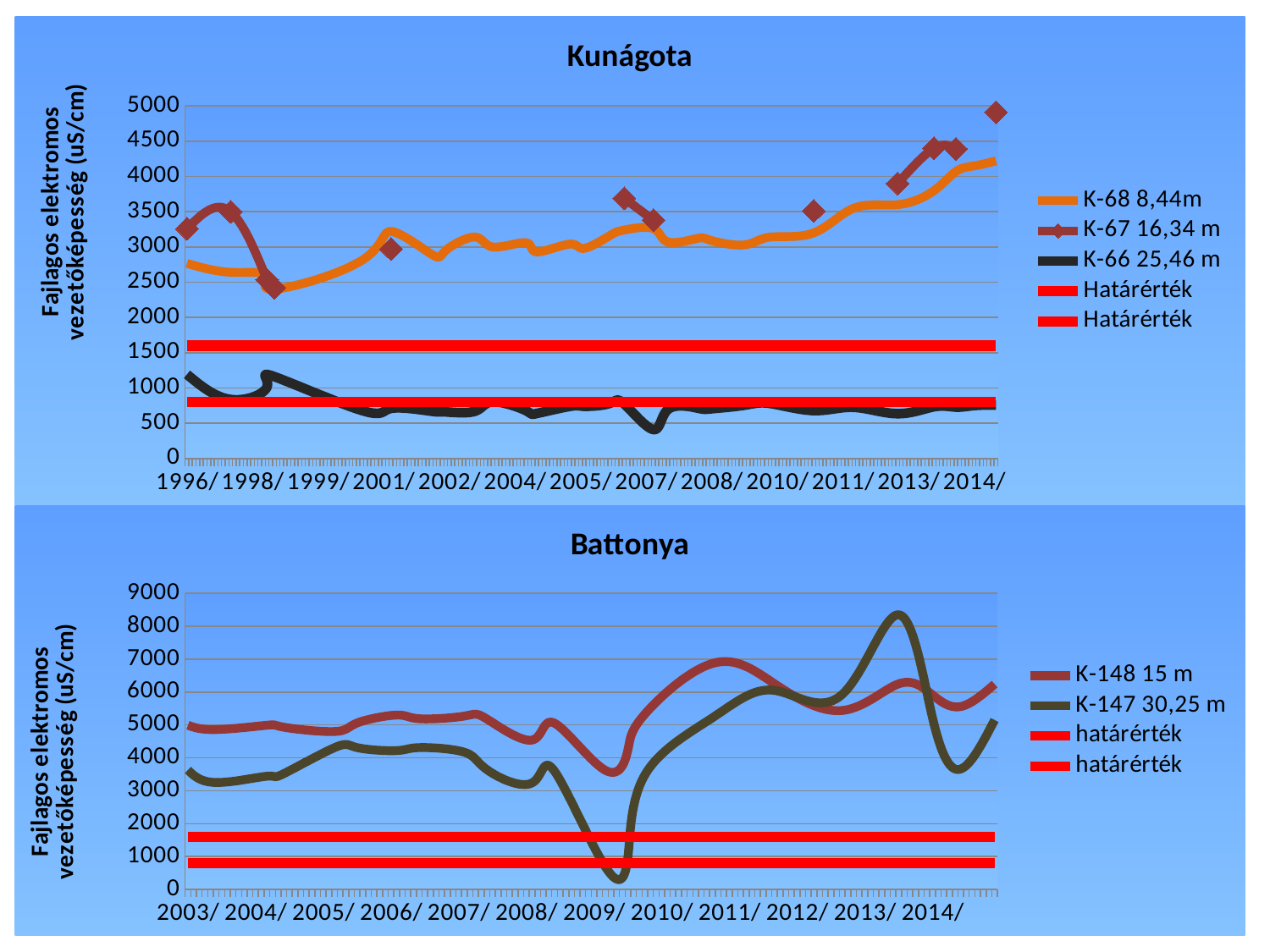
What is the y-axis label of the Battonya chart? Fajlagos elektromos vezetőképesség (uS/cm) In the Kunágota chart, which series has the larger value at 1996, K-67 16,34 m or K-66 25,46 m? K-67 16,34 m In the Kunágota chart, is the value for K-66 25,46 m at 2008 greater or less than 1000? less In the Kunágota chart, does the K-68 8,44m series rise or fall from 2010 to 2014? rise In the Battonya chart, which series reaches the highest value on the chart? K-147 30,25 m In the Battonya chart, which series has the larger value at 2003, K-148 15 m or K-147 30,25 m? K-148 15 m In the Kunágota chart, is the last plotted value for K-67 16,34 m greater or less than 4500? greater How many series does the legend of the Kunágota chart list? 5 What kind of chart is the Kunágota chart? line chart How many series does the legend of the Battonya chart list? 4 In the Kunágota chart, is the value for K-68 8,44m at 2014 greater or less than 4000? greater